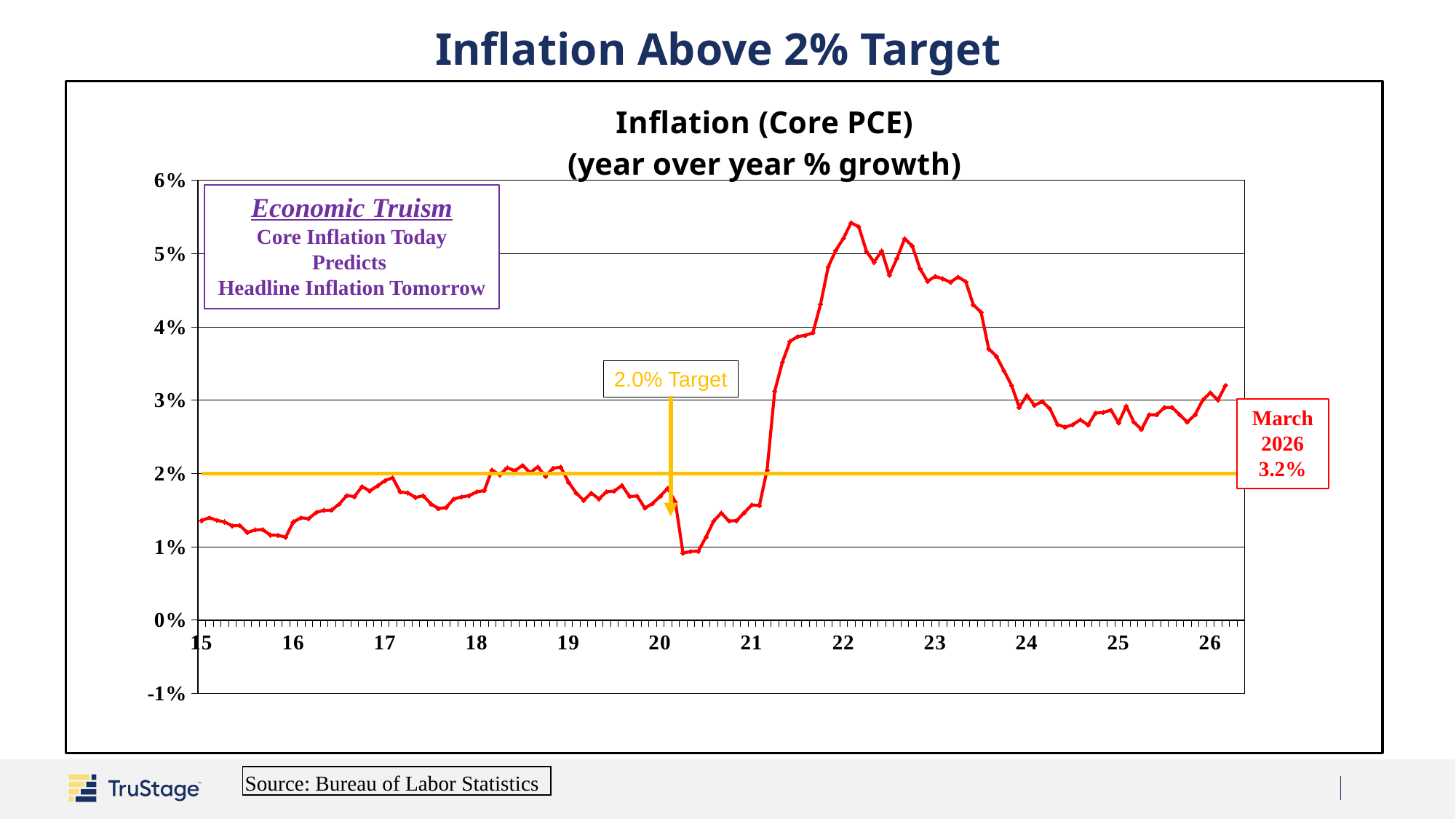
Is the value of the line during 2025 greater or less than 2%? greater What kind of chart is shown on the slide? Line chart Between 2022 and 2024, does the inflation line rise or fall? Fall Is the value of the line at the start of 2016 greater or less than 2%? less Is the peak value of the line in 2022 greater or less than 5%? greater By how many percentage points does the March 2026 value (3.2%) exceed the 2.0% target? 1.2 percentage points In which year does the Core PCE inflation line reach its lowest point? 2020 What is the title of the chart? Inflation (Core PCE) (year over year % growth) What inflation target is marked by the horizontal line on the chart? 2.0% What is the Core PCE inflation value labelled for March 2026? 3.2% In which year does the Core PCE inflation line reach its highest point? 2022 Which is higher, the inflation value in 2022 or in 2019? 2022